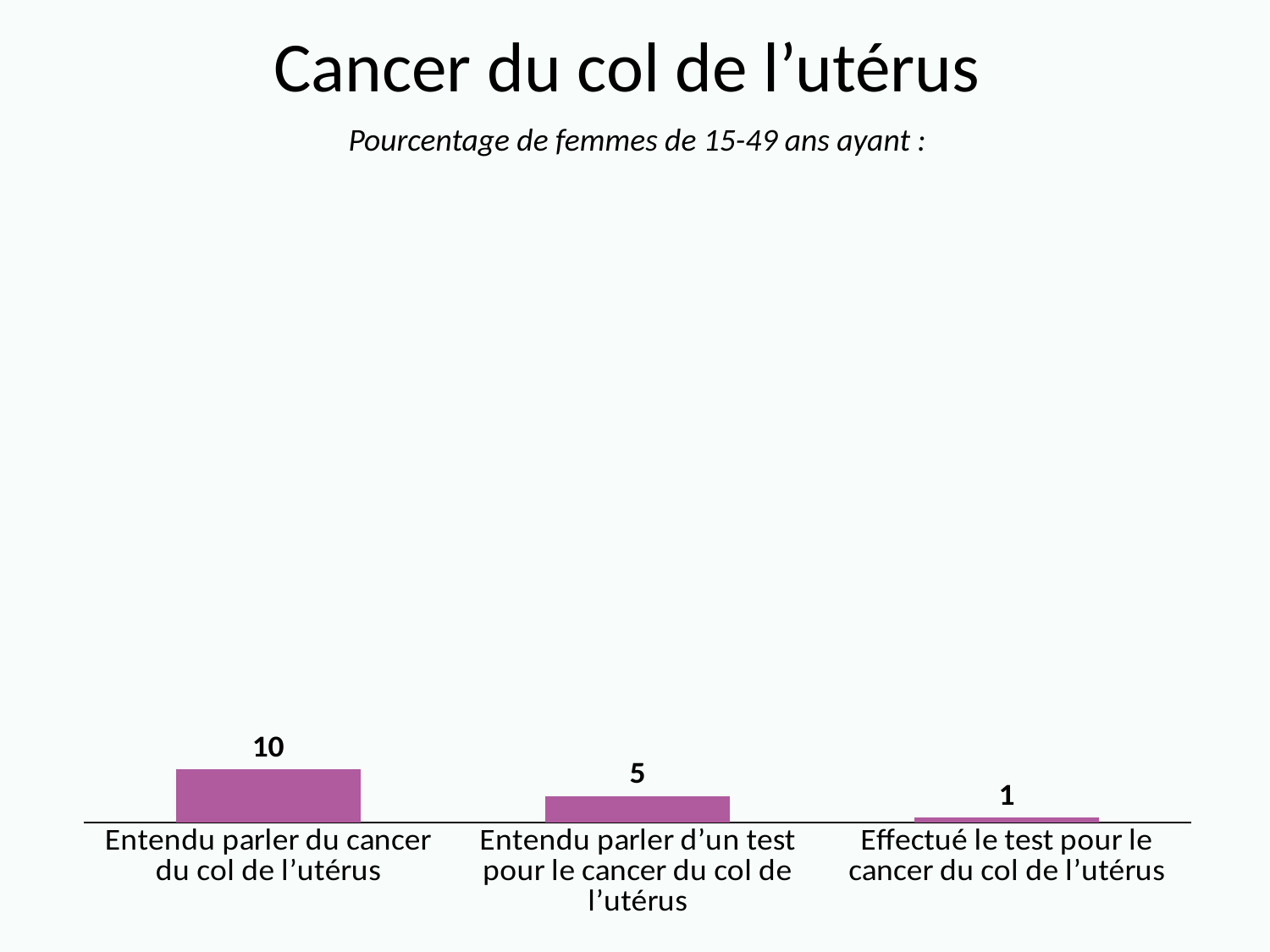
What kind of chart is shown on the slide? Bar chart Which category has the highest value? Entendu parler du cancer du col de l’utérus How many categories are shown in the chart? 3 What is the difference between the values for "Entendu parler d’un test pour le cancer du col de l’utérus" and "Effectué le test pour le cancer du col de l’utérus"? 4 What is the value for "Entendu parler d’un test pour le cancer du col de l’utérus"? 5 What is the value for "Entendu parler du cancer du col de l’utérus"? 10 Which category has the lowest value? Effectué le test pour le cancer du col de l’utérus Which is larger: the value for "Entendu parler d’un test pour le cancer du col de l’utérus" or for "Effectué le test pour le cancer du col de l’utérus"? Entendu parler d’un test pour le cancer du col de l’utérus What is the value for "Effectué le test pour le cancer du col de l’utérus"? 1 Do the values rise or fall from left to right across the categories? Fall What is the title of the slide? Cancer du col de l’utérus What is the difference between the values for "Entendu parler du cancer du col de l’utérus" and "Entendu parler d’un test pour le cancer du col de l’utérus"? 5